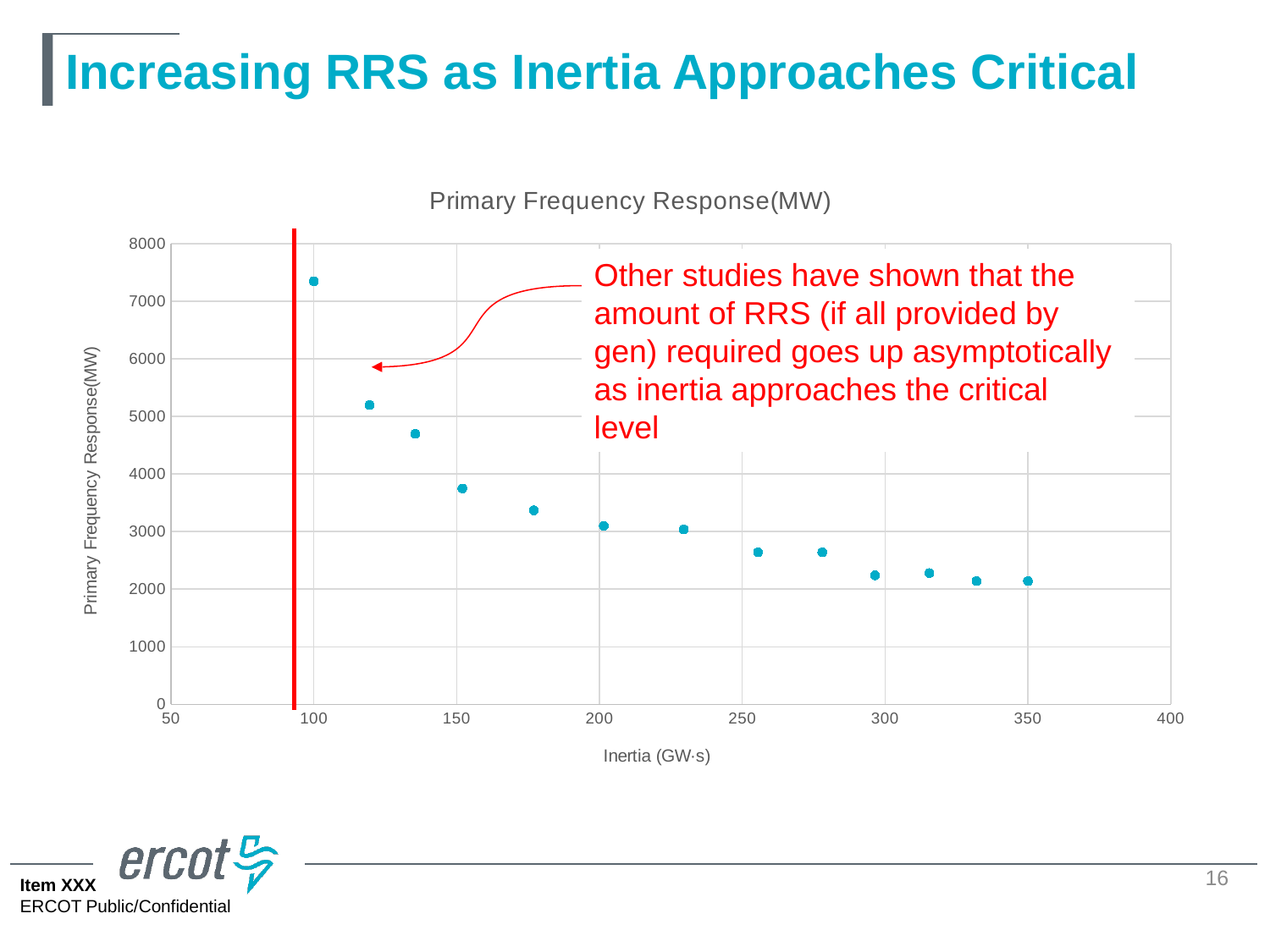
Is the primary frequency response at an inertia of 350 GW·s greater or less than 3000? less What kind of chart is shown on the slide? scatter chart Is the primary frequency response at an inertia of about 120 GW·s greater or less than 5000? greater What is the label of the x axis of the chart? Inertia (GW·s) Is the primary frequency response at an inertia of 100 GW·s greater or less than 7000? greater Which has the larger primary frequency response: the point at an inertia of 100 GW·s or the point at 350 GW·s? 100 GW·s As inertia increases along the x axis, does the primary frequency response rise or fall? fall How many data points are plotted on the chart? 13 What is the title of the chart? Primary Frequency Response(MW) At which inertia value is the primary frequency response highest? 100